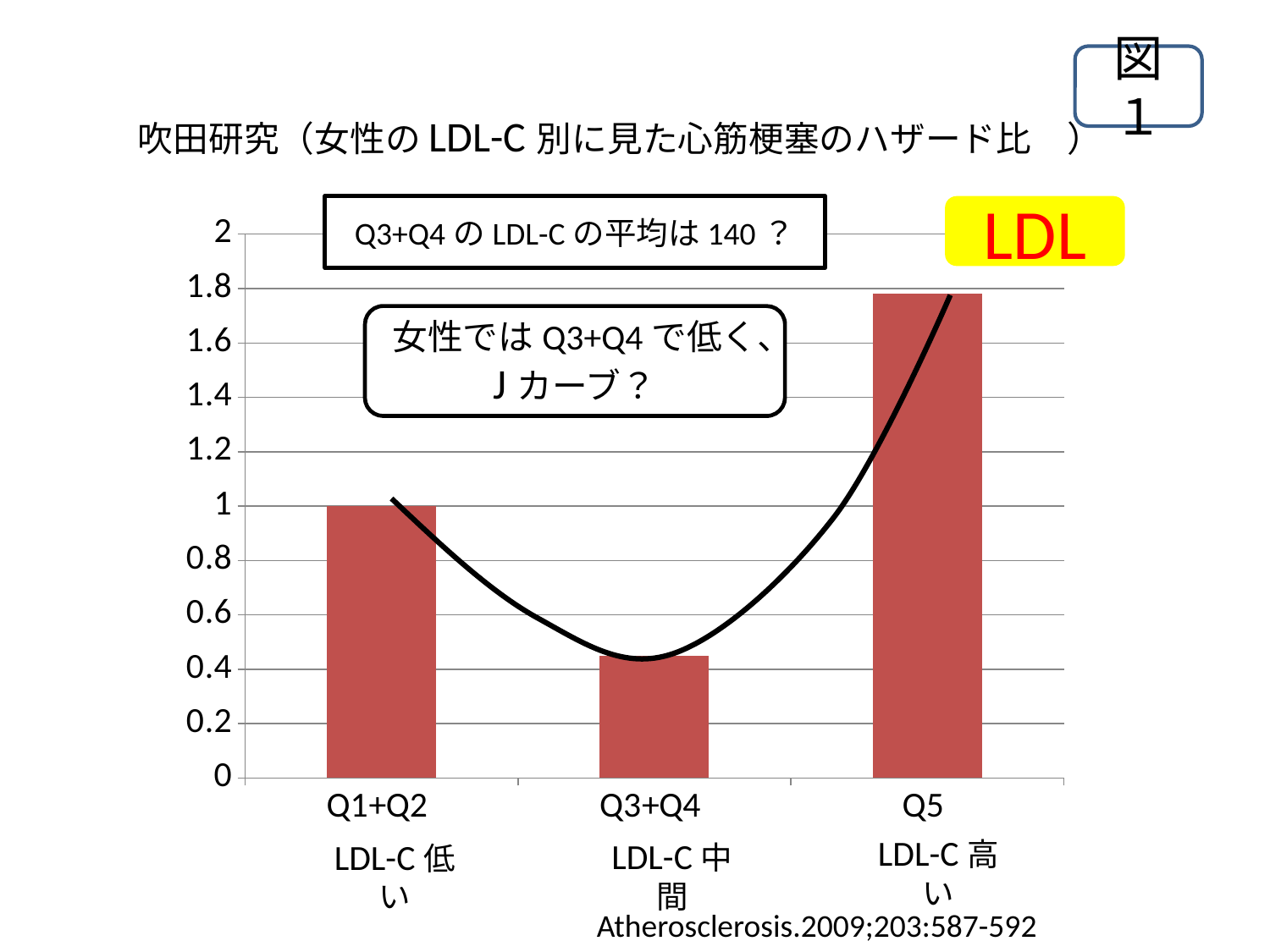
Do the bar values rise or fall from Q3+Q4 to Q5? rise Which category has the highest bar? Q5 Is the value for Q5 greater or less than 2? less Which category has the lowest bar? Q3+Q4 Which is larger, the value for Q1+Q2 or the value for Q3+Q4? Q1+Q2 What type of chart is shown on the slide? bar chart How many categories are plotted on the x axis? 3 Is the value for Q5 greater or less than 1.6? greater Is the value for Q3+Q4 greater or less than 0.6? less What is the hazard ratio value for Q1+Q2? 1 What journal citation is shown below the chart? Atherosclerosis.2009;203:587-592